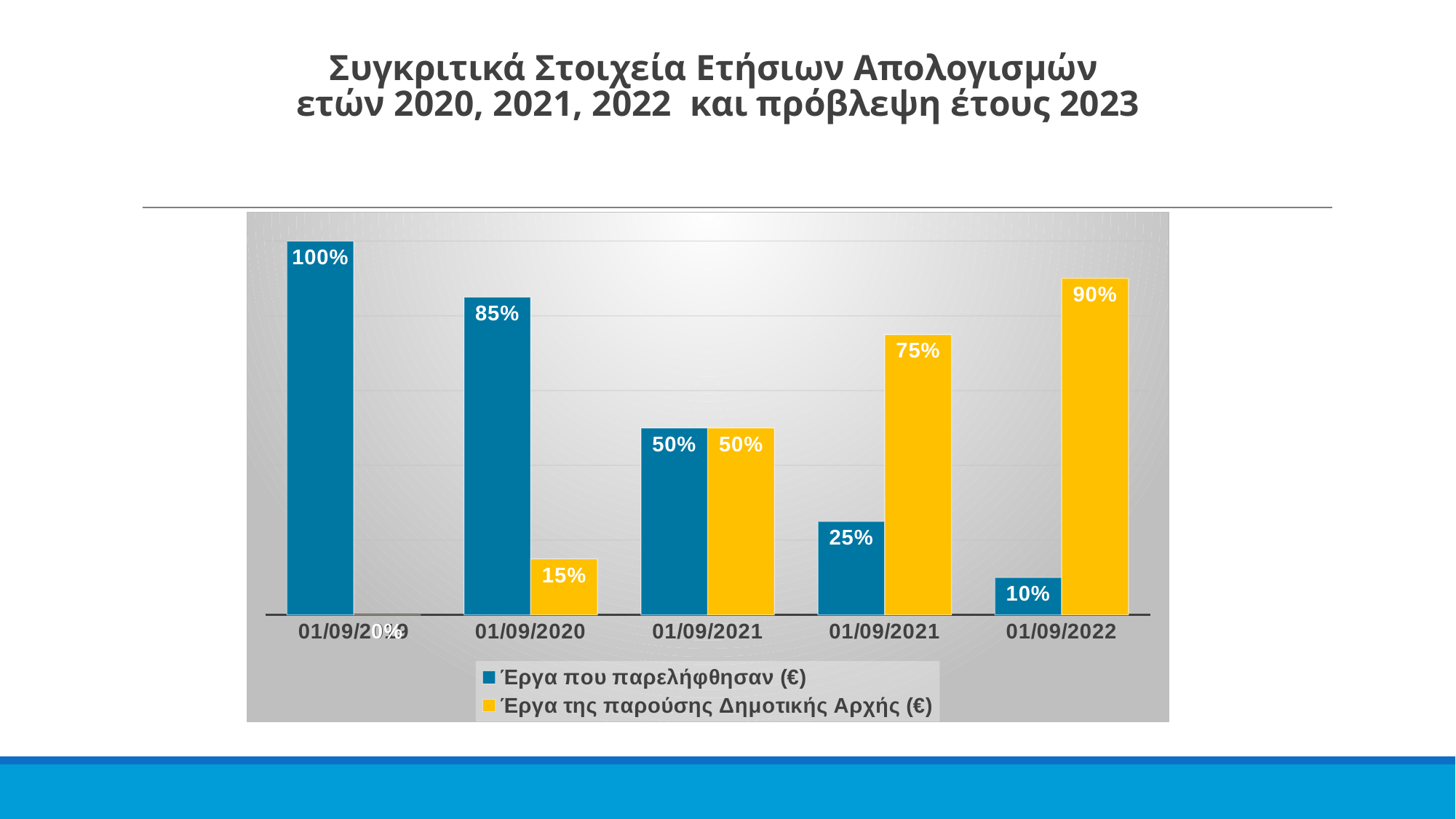
For 01/09/2020, which series has the larger value, blue or yellow? blue (Έργα που παρελήφθησαν) What is the difference between the yellow and blue values for 01/09/2022? 80% How many categories are shown along the x axis? 5 Does the blue series (Έργα που παρελήφθησαν) rise or fall from left to right across the categories? fall Which category has the lowest value for the yellow series (Έργα της παρούσης Δημοτικής Αρχής)? the first category (leftmost), at 0% What is the value of the yellow series (Έργα της παρούσης Δημοτικής Αρχής) for 01/09/2020? 15% What kind of chart is shown on the slide? bar chart Which category has the highest value for the blue series (Έργα που παρελήφθησαν)? the first category (leftmost), at 100% What is the value of the yellow series (Έργα της παρούσης Δημοτικής Αρχής) for 01/09/2022? 90% How many series does the legend list? 2 What is the value of the blue series (Έργα που παρελήφθησαν) for 01/09/2020? 85% What is the value of the blue series (Έργα που παρελήφθησαν) for 01/09/2022? 10%